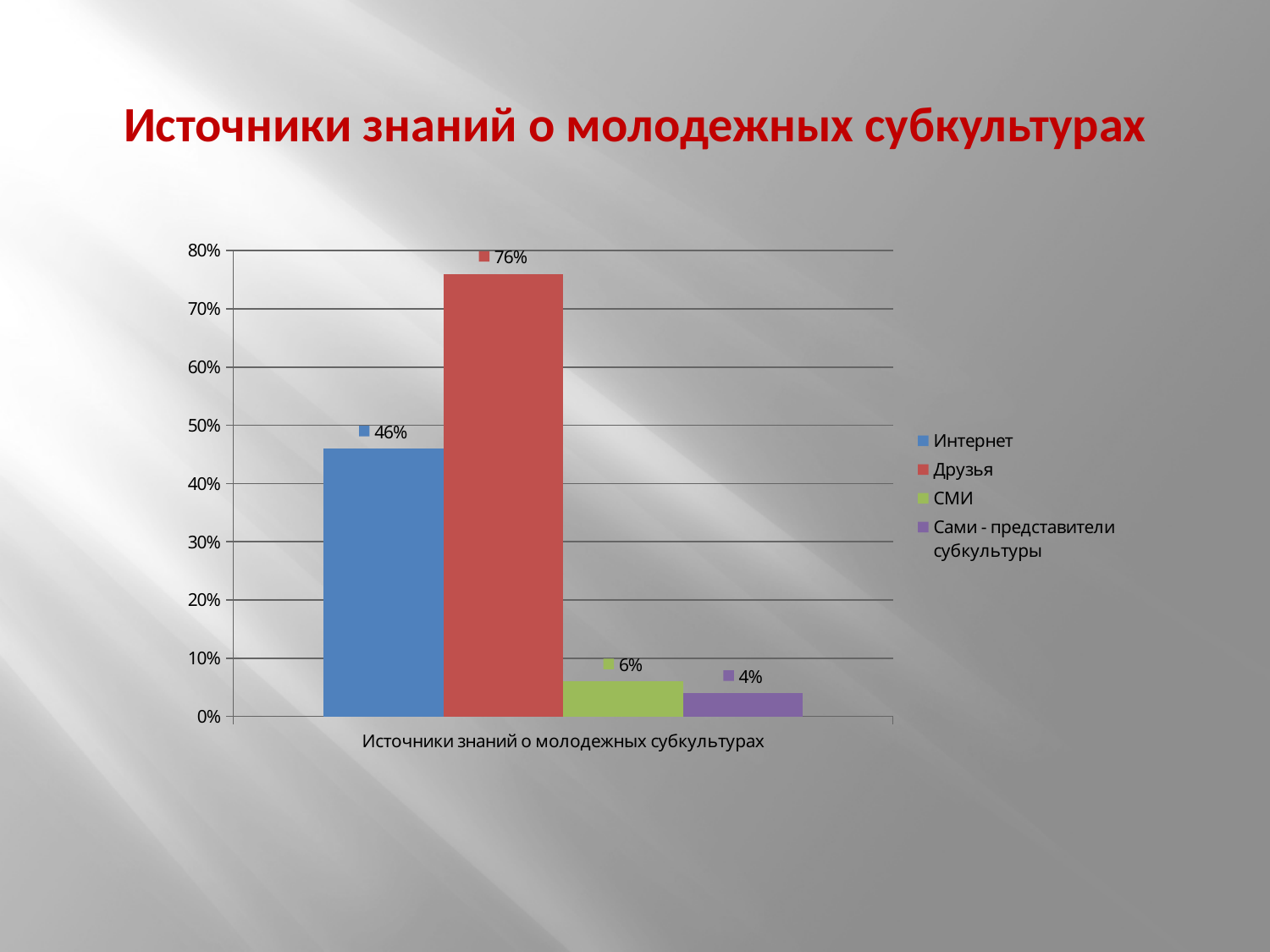
What is the value for СМИ? 6% Which is larger, the value for Интернет or the value for СМИ? Интернет What is the value for Сами - представители субкультуры? 4% Which source has the highest value? Друзья How many series does the legend list? 4 What kind of chart is shown on the slide? bar chart What is the value for Друзья? 76% What is the difference between the values for Друзья and Интернет? 30% What is the title of the slide? Источники знаний о молодежных субкультурах Which source has the lowest value? Сами - представители субкультуры Is the value for Друзья greater or less than 70%? greater What is the value for Интернет? 46%